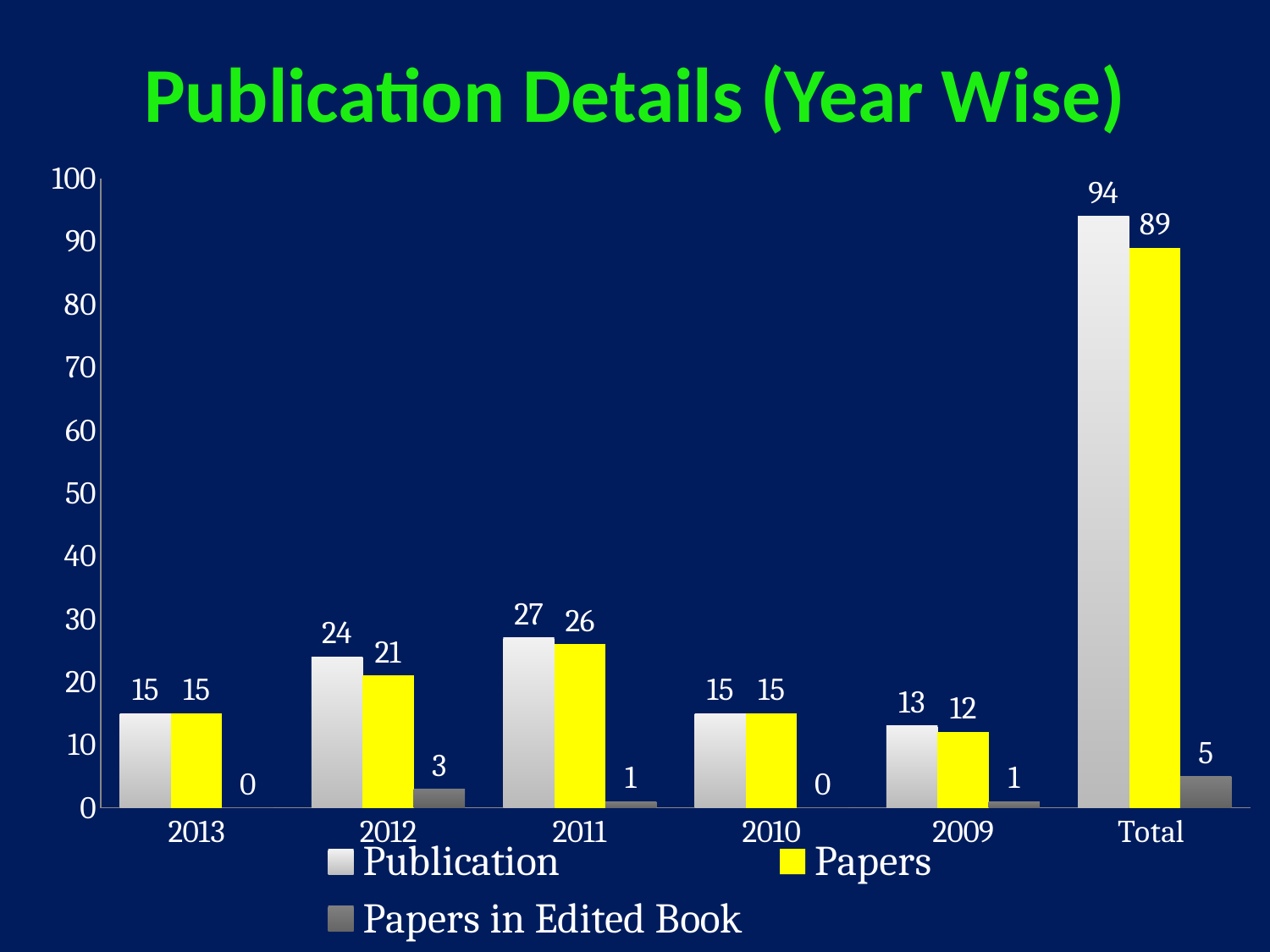
What is the title of the chart? Publication Details (Year Wise) What is the difference between the Publication value and the Papers value in the Total category? 5 What kind of chart is shown on the slide? Bar chart What is the value for Papers in 2011? 26 What is the value for Papers in Edited Book in 2012? 3 How many series does the legend list? 3 Excluding the Total category, which year has the lowest Papers value? 2009 What is the Total value for Papers? 89 Which is larger, the Publication value in 2012 or the Publication value in 2010? 2012 What is the value for Publication in 2012? 24 Excluding the Total category, which year has the highest Publication value? 2011 How many categories are shown on the x axis? 6